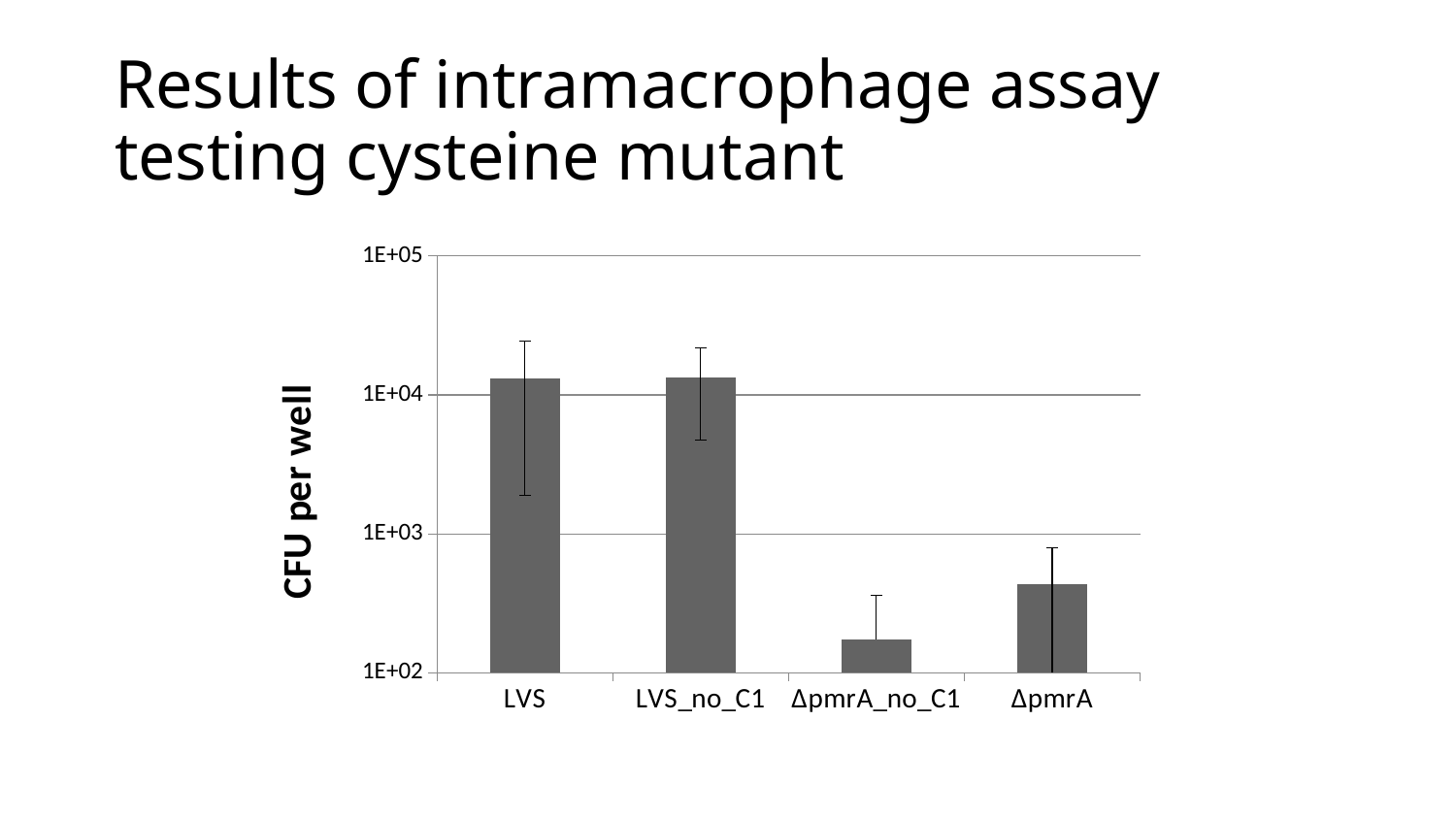
Is the value for ΔpmrA greater or less than 1E+03? less Which is larger, the value for ΔpmrA_no_C1 or the value for ΔpmrA? ΔpmrA Is the value for LVS greater or less than 1E+04? greater How many categories are plotted on the x axis of the chart? 4 Which is larger, the value for LVS or the value for ΔpmrA_no_C1? LVS What is the label of the first category on the x axis? LVS What kind of chart is shown on the slide? bar chart Which category has the lowest CFU per well? ΔpmrA_no_C1 What is the label of the y axis of the chart? CFU per well Which is larger, the value for LVS_no_C1 or the value for ΔpmrA? LVS_no_C1 Is the value for LVS_no_C1 greater or less than 1E+05? less